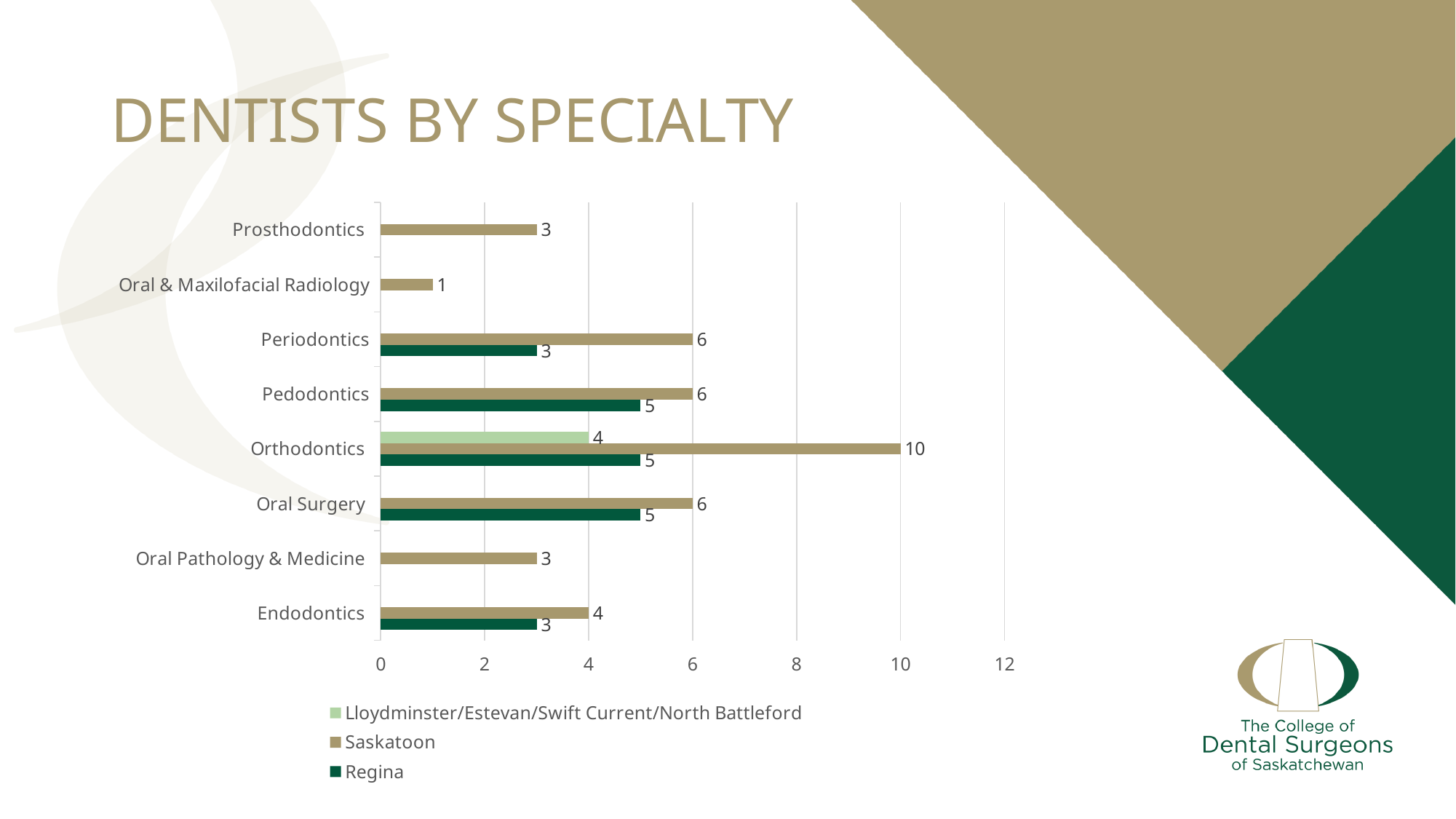
Which specialty has the lowest Saskatoon value? Oral & Maxilofacial Radiology What is the difference between the Saskatoon and Regina values for Periodontics? 3 What is the Saskatoon value for Orthodontics? 10 What kind of chart is shown on the slide? Bar chart What is the Lloydminster/Estevan/Swift Current/North Battleford value for Orthodontics? 4 Which specialty has the highest Saskatoon value? Orthodontics How many specialties are listed on the chart? 8 How many series does the legend list? 3 What is the title of the slide? DENTISTS BY SPECIALTY What is the Saskatoon value for Oral & Maxilofacial Radiology? 1 Which is larger for Endodontics, the Saskatoon value or the Regina value? Saskatoon What is the Regina value for Pedodontics? 5